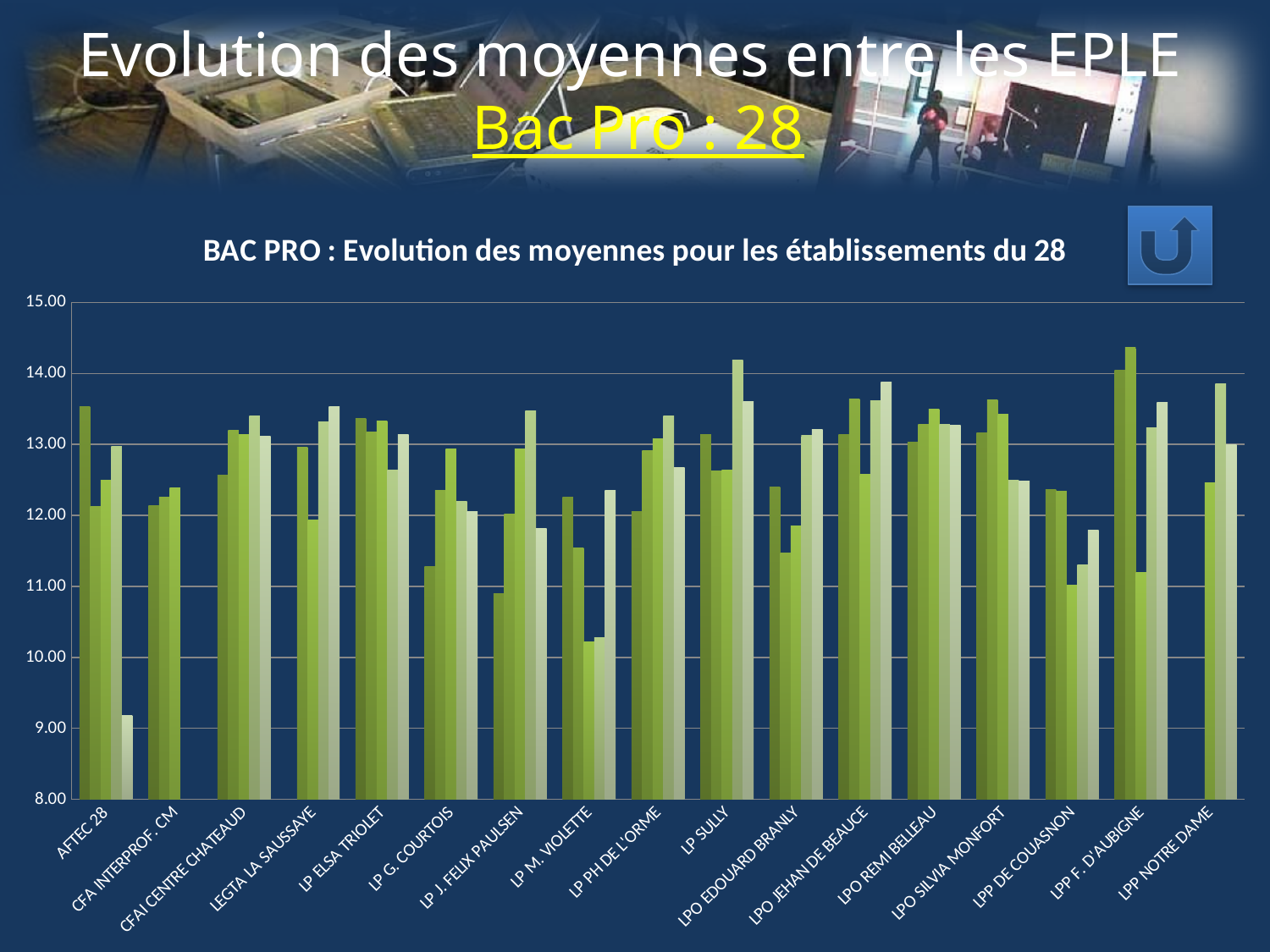
Is the lowest bar for LP M. VIOLETTE greater or less than 11.00? less Which has the lower minimum bar: AFTEC 28 or LP M. VIOLETTE? AFTEC 28 Is the lowest bar for AFTEC 28 greater or less than 10.00? less Is the tallest bar for LPP F. D'AUBIGNE greater or less than 14.00? greater What is the title of the chart? BAC PRO : Evolution des moyennes pour les établissements du 28 How many establishments (categories) are shown on the x axis of the chart? 17 Which establishment contains the lowest bar on the chart? AFTEC 28 What kind of chart is shown on the slide? bar chart What is the highest value shown on the chart's vertical axis? 15.00